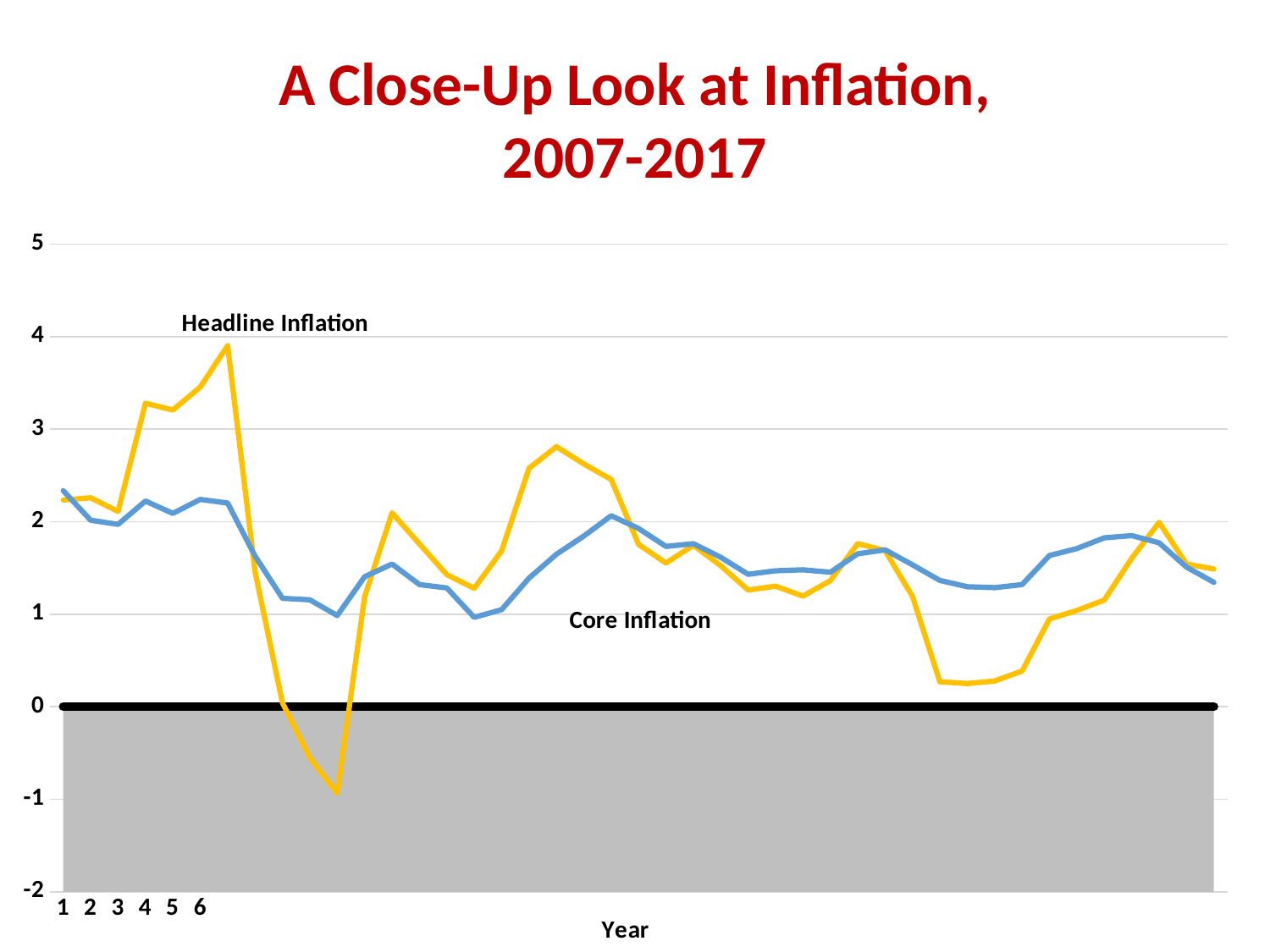
Is the lowest value of Core Inflation greater or less than 0? greater Is the highest value of Headline Inflation greater or less than 3? greater Is the highest value of Core Inflation greater or less than 2? greater Which series reaches the highest value on the chart? Headline Inflation Which series is higher at the far right end of the chart, Headline Inflation or Core Inflation? Headline Inflation What is the title of the chart on the slide? A Close-Up Look at Inflation, 2007-2017 Which series reaches the lowest value on the chart? Headline Inflation What kind of chart is shown on the slide? Line chart How many series are plotted on the chart? 2 What is the label on the horizontal axis of the chart? Year